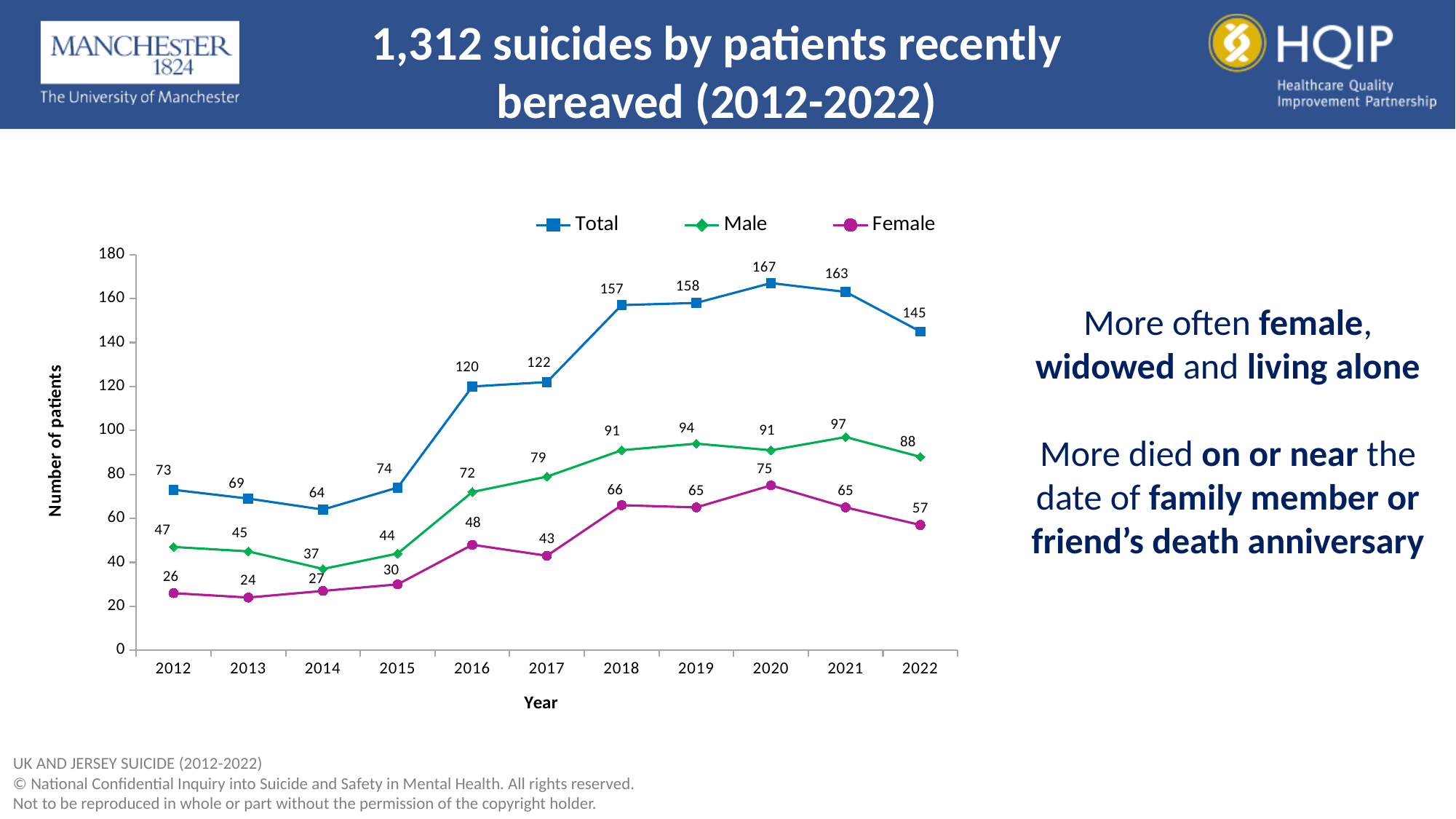
What is the difference between the Total values for 2021 and 2022? 18 In which year is the Female series lowest? 2013 Which is larger, the Male value for 2019 or the Male value for 2021? 2021 Does the Total series rise or fall from 2015 to 2018? Rise What kind of chart is shown on the slide? Line chart What is the label of the y axis? Number of patients In which year is the Total series highest? 2020 How many series does the legend list? 3 What is the Female value for 2013? 24 What is the Male value for 2017? 79 What is the Total value for 2020? 167 How many years are shown on the x axis? 11